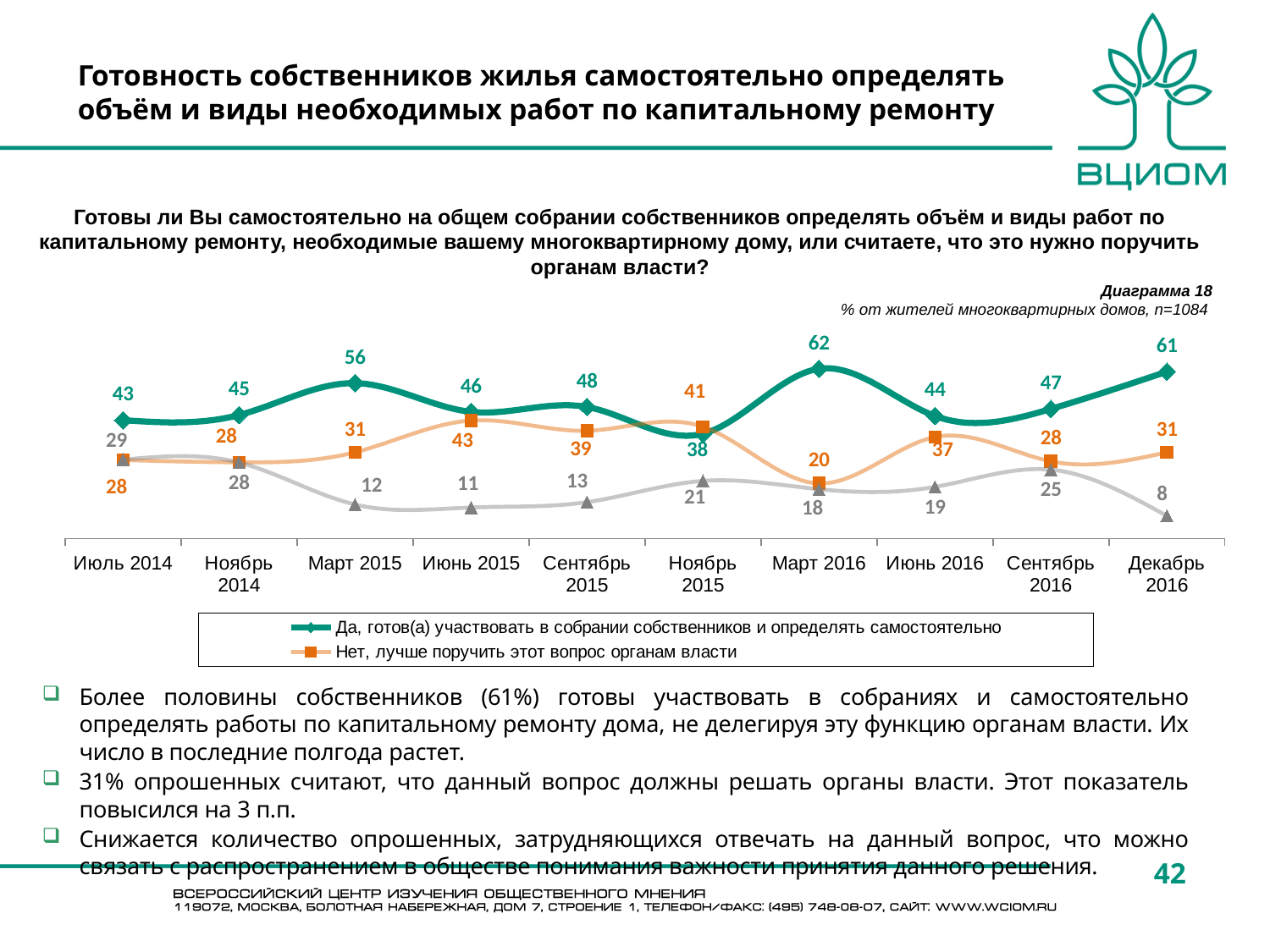
At which time point does the series "Нет, лучше поручить этот вопрос органам власти" have its lowest value? Март 2016 What is the value of the series "Нет, лучше поручить этот вопрос органам власти" for Июнь 2015? 43 How many time points are shown on the x axis of the chart? 10 What is the difference between the "Да, готов(а)..." value and the "Нет, лучше поручить..." value in Март 2016? 42 Between Сентябрь 2016 and Декабрь 2016, does the series "Да, готов(а) участвовать..." rise or fall? rise What is the diagram number given above the chart? Диаграмма 18 How many series does the chart legend list? 2 Which series has the larger value in Июнь 2015: "Да, готов(а) участвовать..." or "Нет, лучше поручить..."? Да, готов(а) участвовать в собрании собственников и определять самостоятельно What type of chart is shown on the slide? line chart At which time point does the series "Да, готов(а) участвовать в собрании собственников и определять самостоятельно" reach its highest value? Март 2016 What is the value of the series "Да, готов(а) участвовать в собрании собственников и определять самостоятельно" for Ноябрь 2015? 38 What is the value of the series "Да, готов(а) участвовать в собрании собственников и определять самостоятельно" for Декабрь 2016? 61